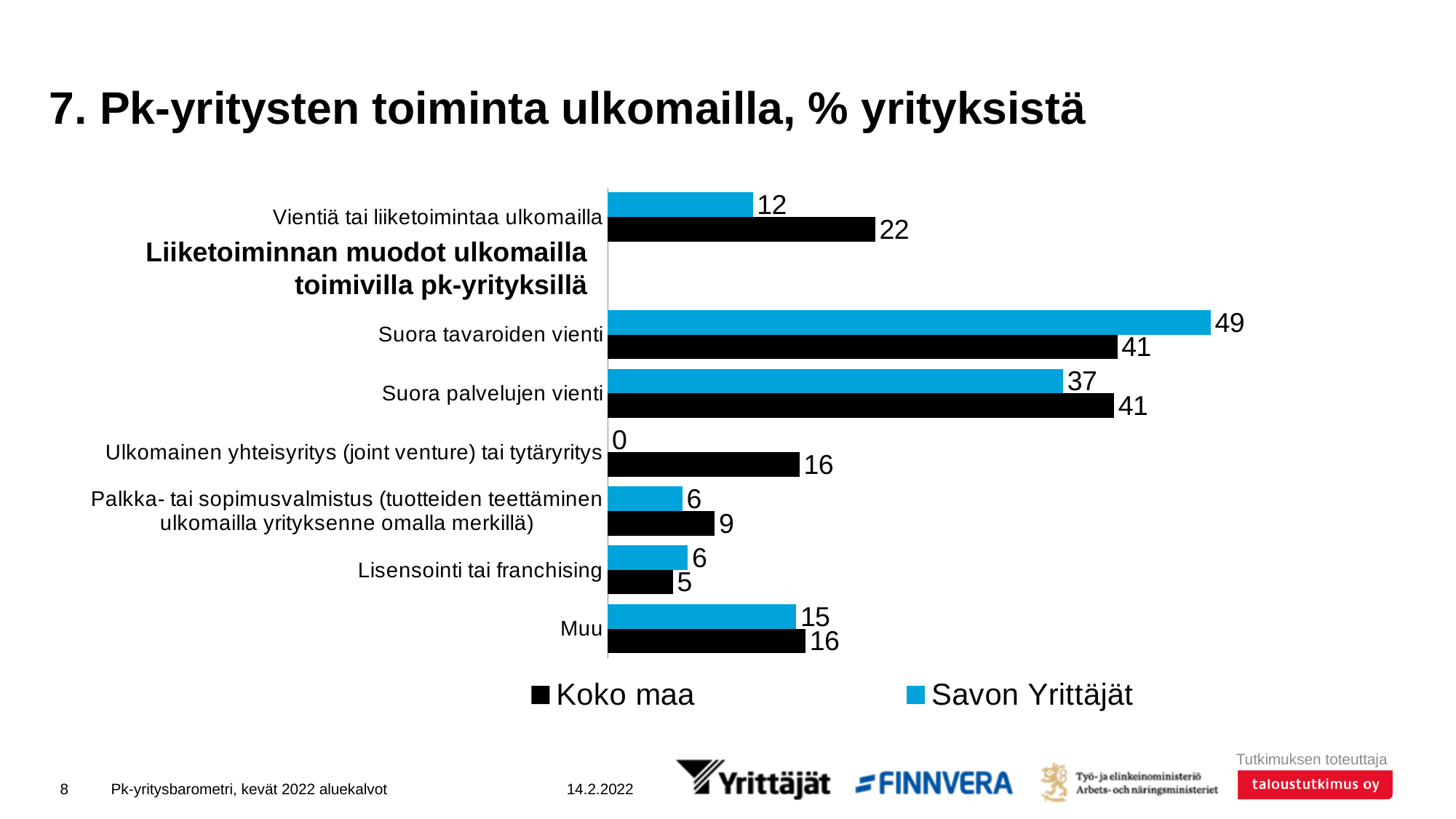
Which colour represents Savon Yrittäjät in the chart? Blue Which category has the highest value for Savon Yrittäjät? Suora tavaroiden vienti What is the value for Savon Yrittäjät for Ulkomainen yhteisyritys (joint venture) tai tytäryritys? 0 What is the value for Koko maa for Lisensointi tai franchising? 5 What is the value for Savon Yrittäjät for Suora tavaroiden vienti? 49 What is the value for Koko maa for Vientiä tai liiketoimintaa ulkomailla? 22 What kind of chart is shown on the slide? Bar chart What is the difference between the Koko maa and Savon Yrittäjät values for Ulkomainen yhteisyritys (joint venture) tai tytäryritys? 16 Which category has the lowest value for Koko maa? Lisensointi tai franchising For Suora palvelujen vienti, which series has the larger value, Koko maa or Savon Yrittäjät? Koko maa How many series does the legend list? 2 What is the difference between the Savon Yrittäjät and Koko maa values for Suora tavaroiden vienti? 8